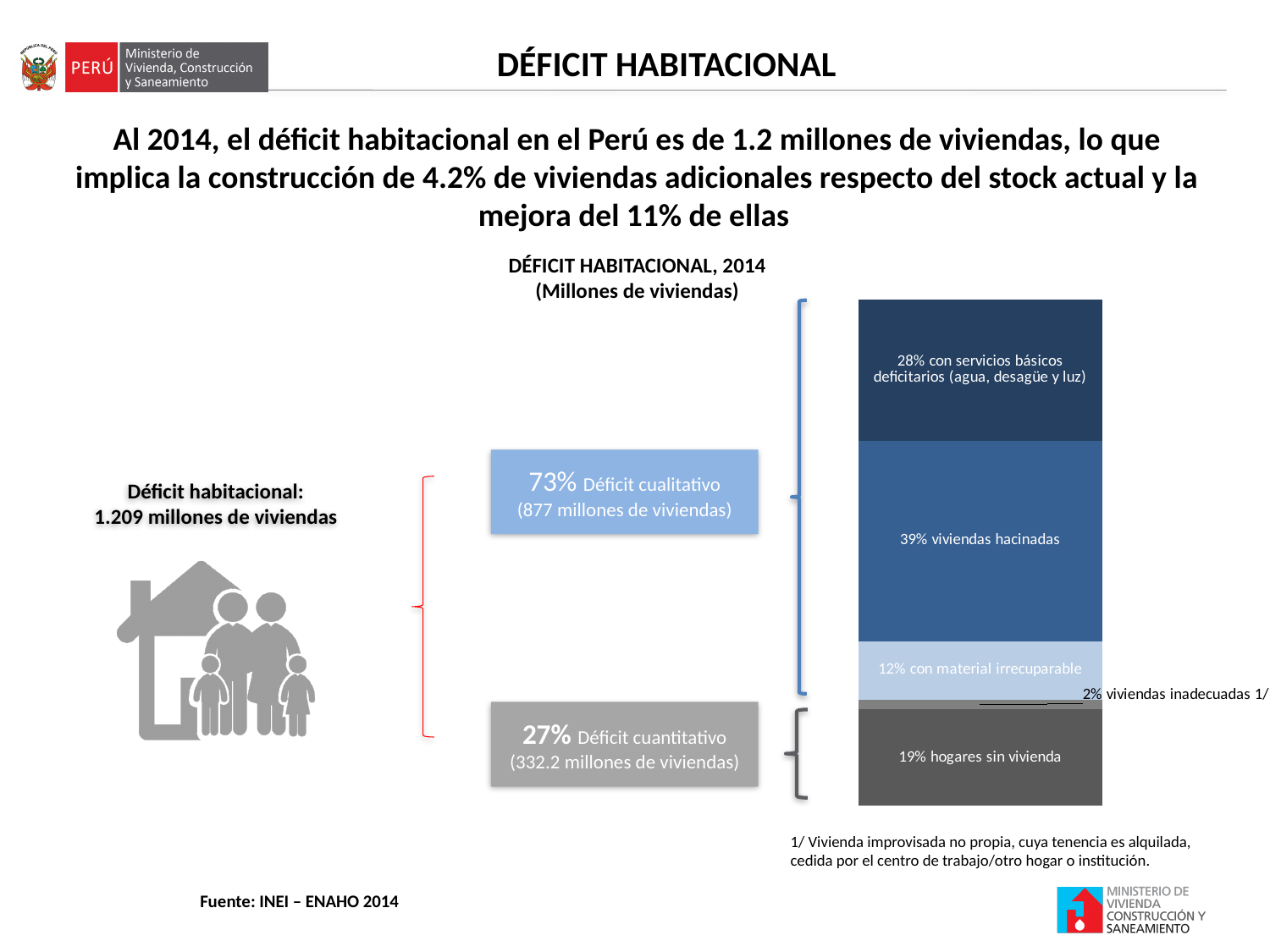
Which segment of the stacked bar has the largest share? 39% viviendas hacinadas What is the difference in percentage points between 'viviendas hacinadas' and 'con servicios básicos deficitarios'? 11 What percentage is shown for 'con material irrecuperable'? 12% What percentage of the housing deficit is attributed to 'viviendas hacinadas' in the stacked bar? 39% What kind of chart is used to show the components of the housing deficit? stacked bar chart Which segment of the stacked bar has the smallest share? 2% viviendas inadecuadas 1/ What is the title of the chart? DÉFICIT HABITACIONAL, 2014 (Millones de viviendas) What percentage of the housing deficit corresponds to 'con servicios básicos deficitarios (agua, desagüe y luz)'? 28% How many segments make up the stacked bar? 5 Which is larger: the share for 'hogares sin vivienda' or the share for 'con material irrecuperable'? hogares sin vivienda What percentage is shown for 'hogares sin vivienda' in the stacked bar? 19% What percentage is shown for 'viviendas inadecuadas 1/'? 2%